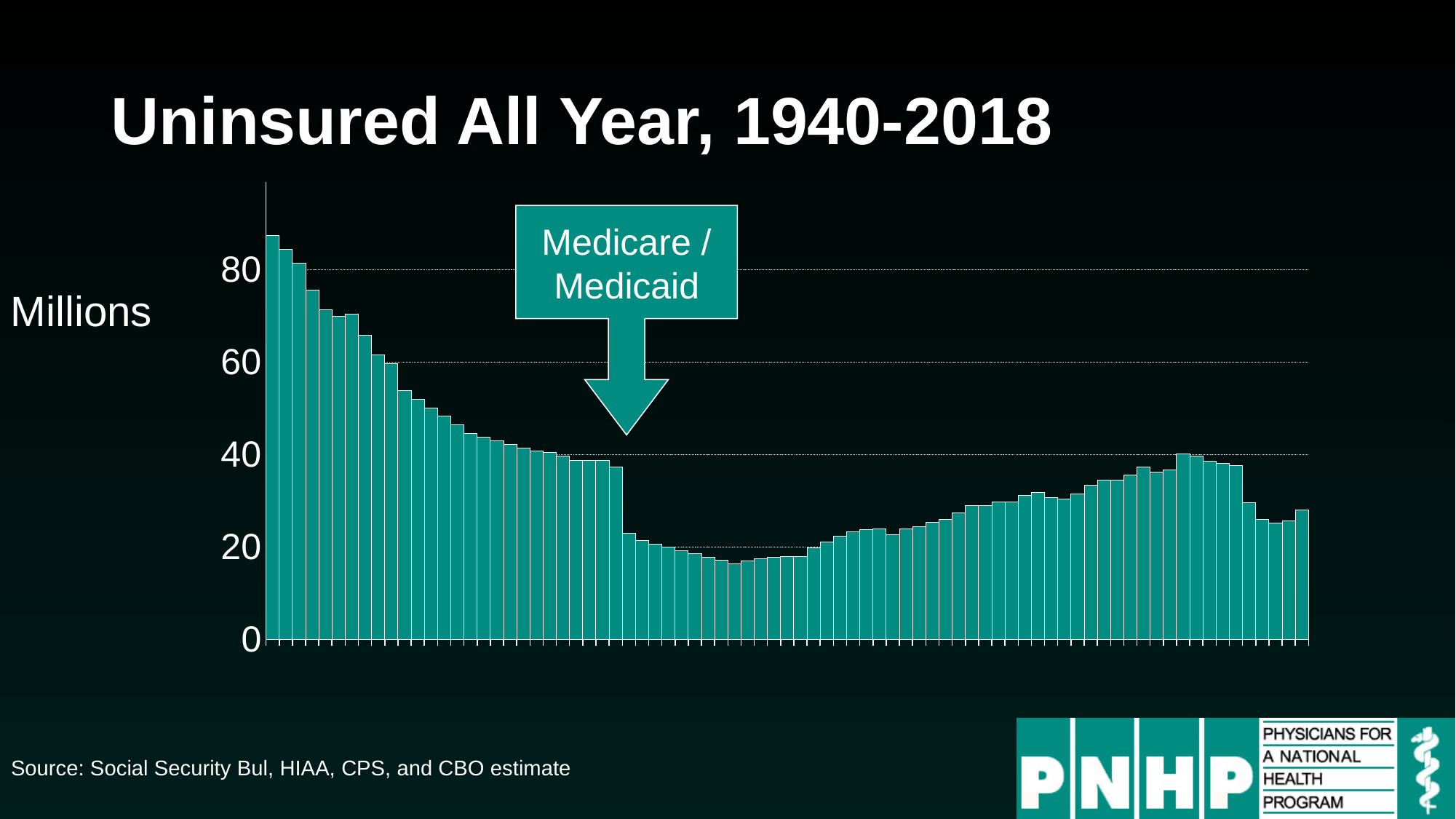
What is the title of the chart? Uninsured All Year, 1940-2018 Is the value of the bar immediately before the Medicare / Medicaid arrow greater or less than 20? greater Do the values rise or fall from the left edge of the chart up to the Medicare / Medicaid arrow? fall Is the value of the lowest bar in the chart greater or less than 20? less Is the value of the bar immediately after the Medicare / Medicaid arrow greater or less than 40? less What unit label is shown beside the vertical axis of the chart? Millions Is the tallest bar in the chart at the left end or the right end of the x axis? Left end What is the highest value labelled on the vertical axis? 80 What kind of chart is shown on the slide? Bar chart Which is larger, the leftmost bar (1940) or the rightmost bar (2018)? The leftmost bar (1940)